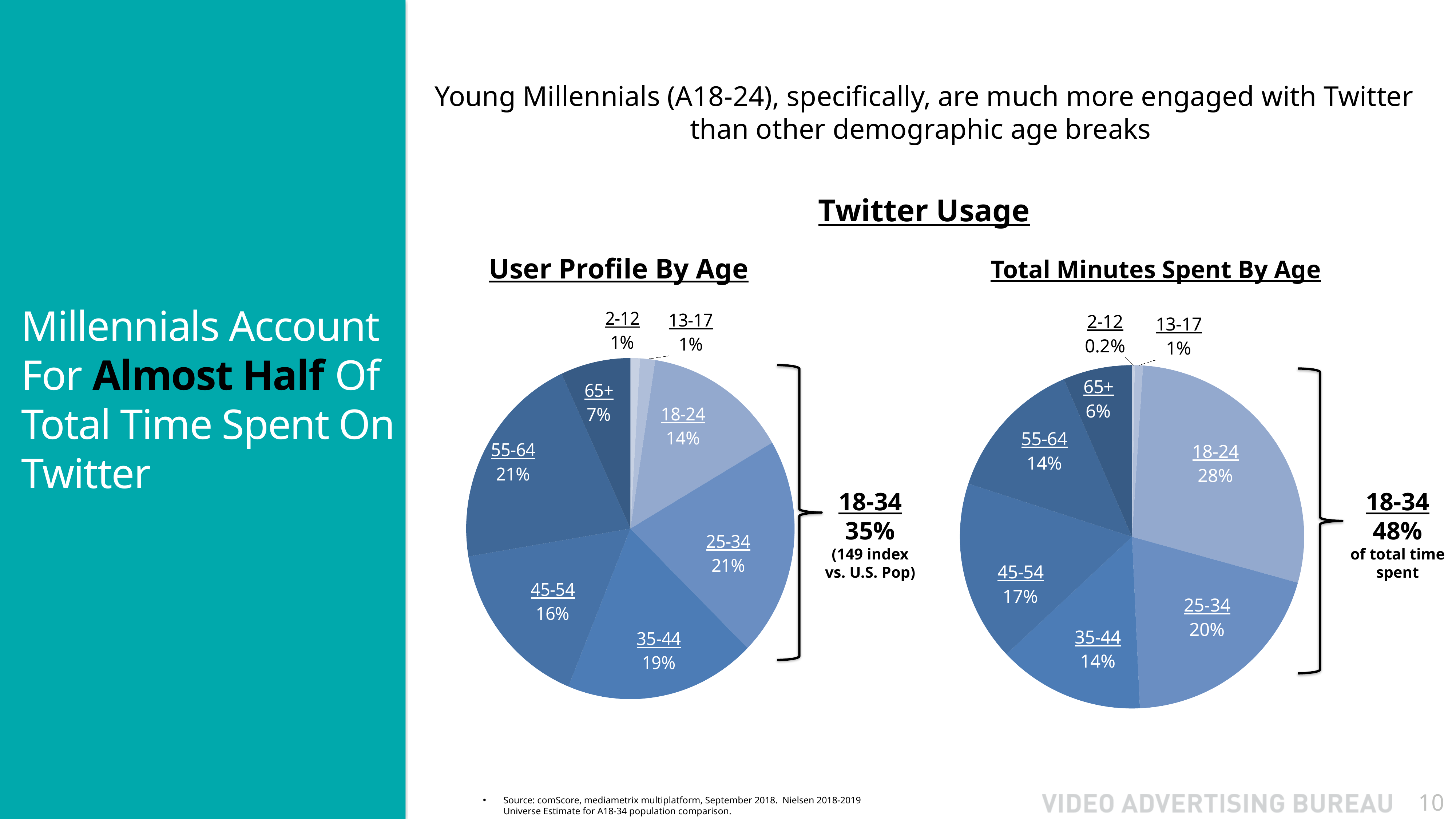
According to the bracket annotation on the Total Minutes Spent By Age chart, what share of total time spent is attributed to the 18-34 group? 48% In the Total Minutes Spent By Age chart, what is the value for the 2-12 age group? 0.2% In the User Profile By Age chart, what is the value for the 65+ age group? 7% In the Total Minutes Spent By Age chart, which is larger: the 45-54 share or the 55-64 share? 45-54 How many age groups are shown in the User Profile By Age chart? 8 In the User Profile By Age chart, what share of users is aged 18-24? 14% In the Total Minutes Spent By Age chart, which age group has the smallest share? 2-12 What is the difference between the 18-24 share in the Total Minutes Spent By Age chart and the 18-24 share in the User Profile By Age chart? 14 percentage points What type of chart is the Total Minutes Spent By Age chart? Pie chart In the User Profile By Age chart, which is larger: the 35-44 share or the 45-54 share? 35-44 In the Total Minutes Spent By Age chart, which age group has the largest share? 18-24 In the Total Minutes Spent By Age chart, what share of total minutes is attributed to the 18-24 age group? 28%